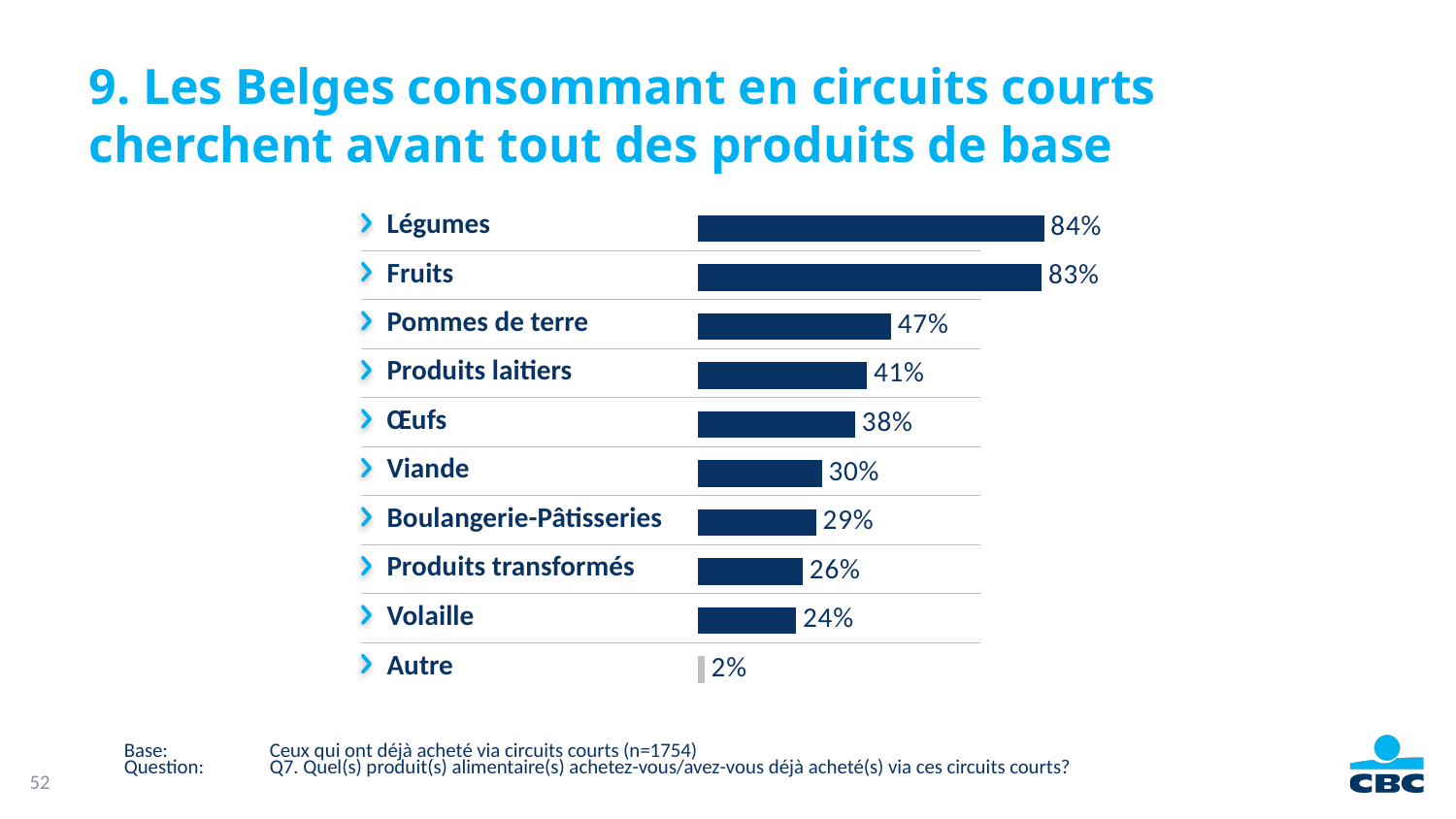
What is the value for Pommes de terre? 47% How many categories are shown in the chart? 10 Which category has the lowest value? Autre What is the value for Boulangerie-Pâtisseries? 29% Which category has the highest value? Légumes What kind of chart is shown on the slide? Bar chart What is the value for Volaille? 24% What is the value for Légumes? 84% What is the sample size (n) given in the base note below the chart? n=1754 What is the difference between the values for Légumes and Pommes de terre? 37% Which is larger, the value for Viande or the value for Produits transformés? Viande What is the difference between the values for Produits laitiers and Œufs? 3%